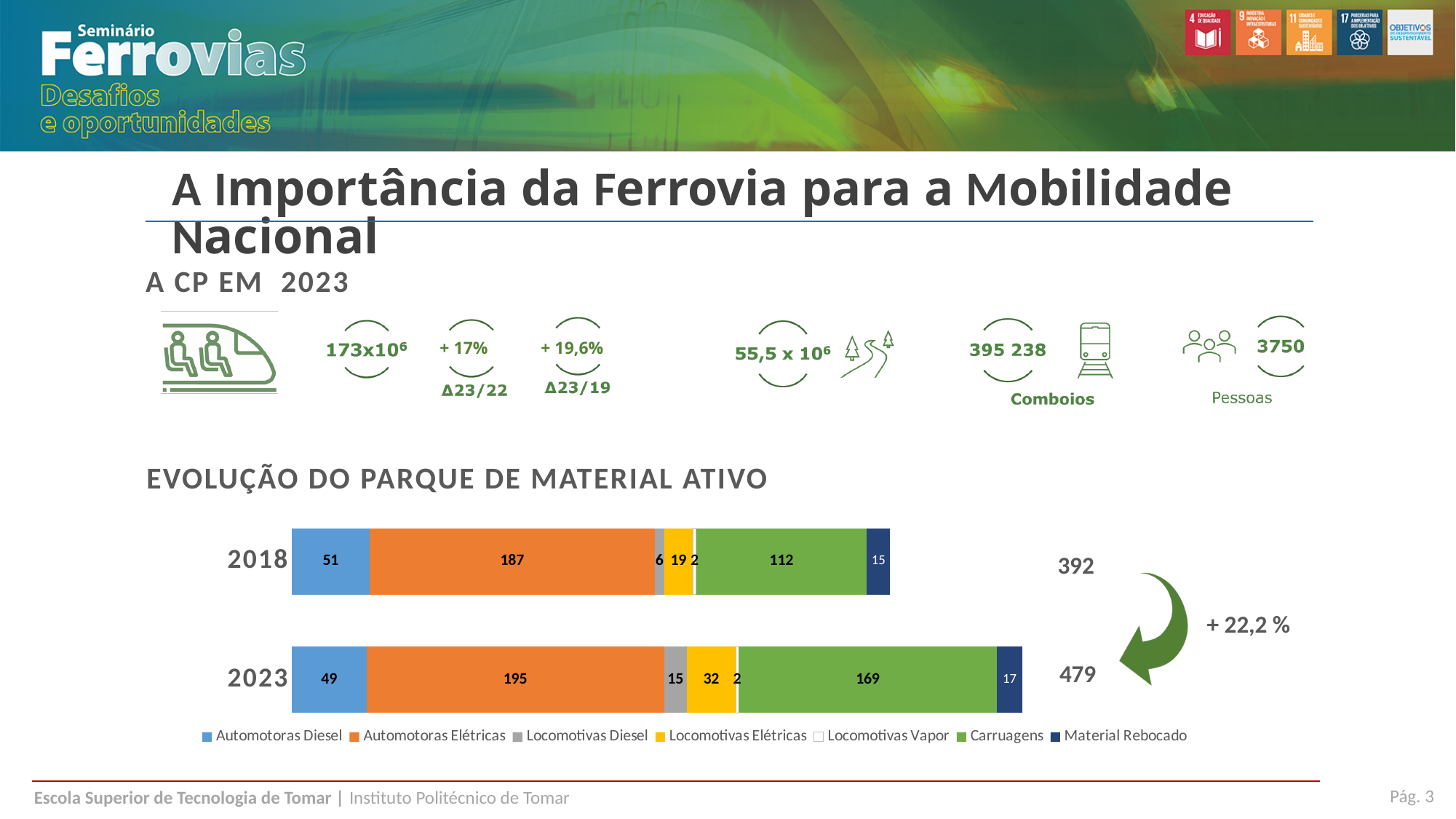
Is the value of Automotoras Diesel larger in 2018 or in 2023? 2018 Which series has the smallest value in the 2018 bar? Locomotivas Vapor What is the value of Automotoras Elétricas in 2023? 195 How many years (categories) are plotted in the stacked bar chart? 2 What is the total of the 2023 stacked bar? 479 Which series has the largest value in the 2023 bar? Automotoras Elétricas What is the total of the 2018 stacked bar? 392 What is the value of Carruagens in 2018? 112 How many series does the legend of the stacked bar chart list? 7 By how much did Carruagens increase from 2018 to 2023? 57 What is the value of Locomotivas Diesel in 2023? 15 What type of chart is shown under "EVOLUÇÃO DO PARQUE DE MATERIAL ATIVO"? Stacked bar chart